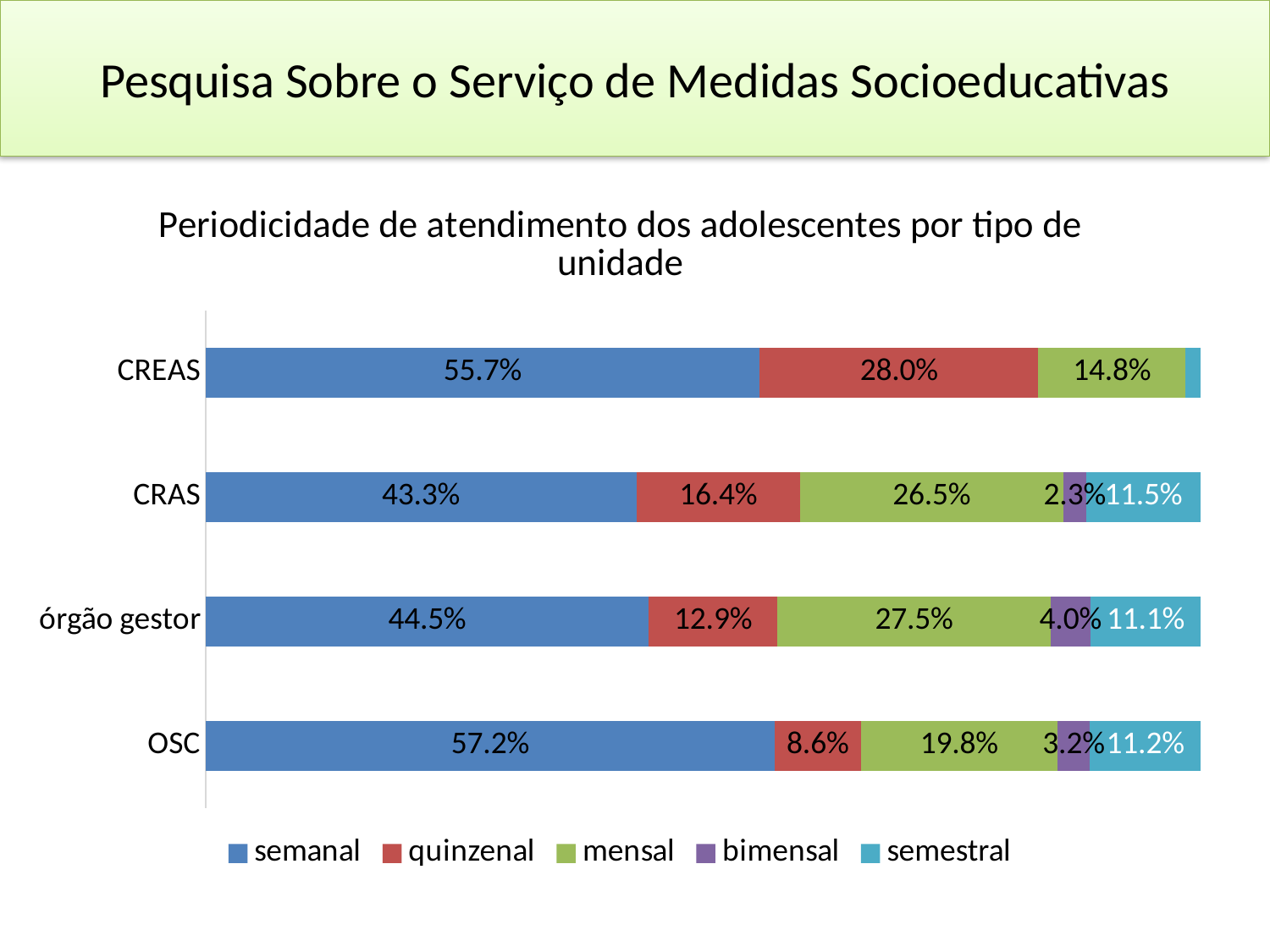
What is the 'quinzenal' value for OSC? 8.6% How many series does the legend list? 5 Which is larger, the 'mensal' value for CRAS or for OSC? CRAS What type of chart is shown on the slide? stacked bar chart Which unit type has the highest 'semanal' value? OSC What is the title of the chart? Periodicidade de atendimento dos adolescentes por tipo de unidade What is the 'semestral' value for CRAS? 11.5% What is the difference between the 'quinzenal' values for CREAS and CRAS? 11.6% Which unit type has the lowest 'quinzenal' value? OSC What is the 'mensal' value for órgão gestor? 27.5% What is the 'semanal' value for CREAS? 55.7% How many unit types (categories) are shown on the chart? 4